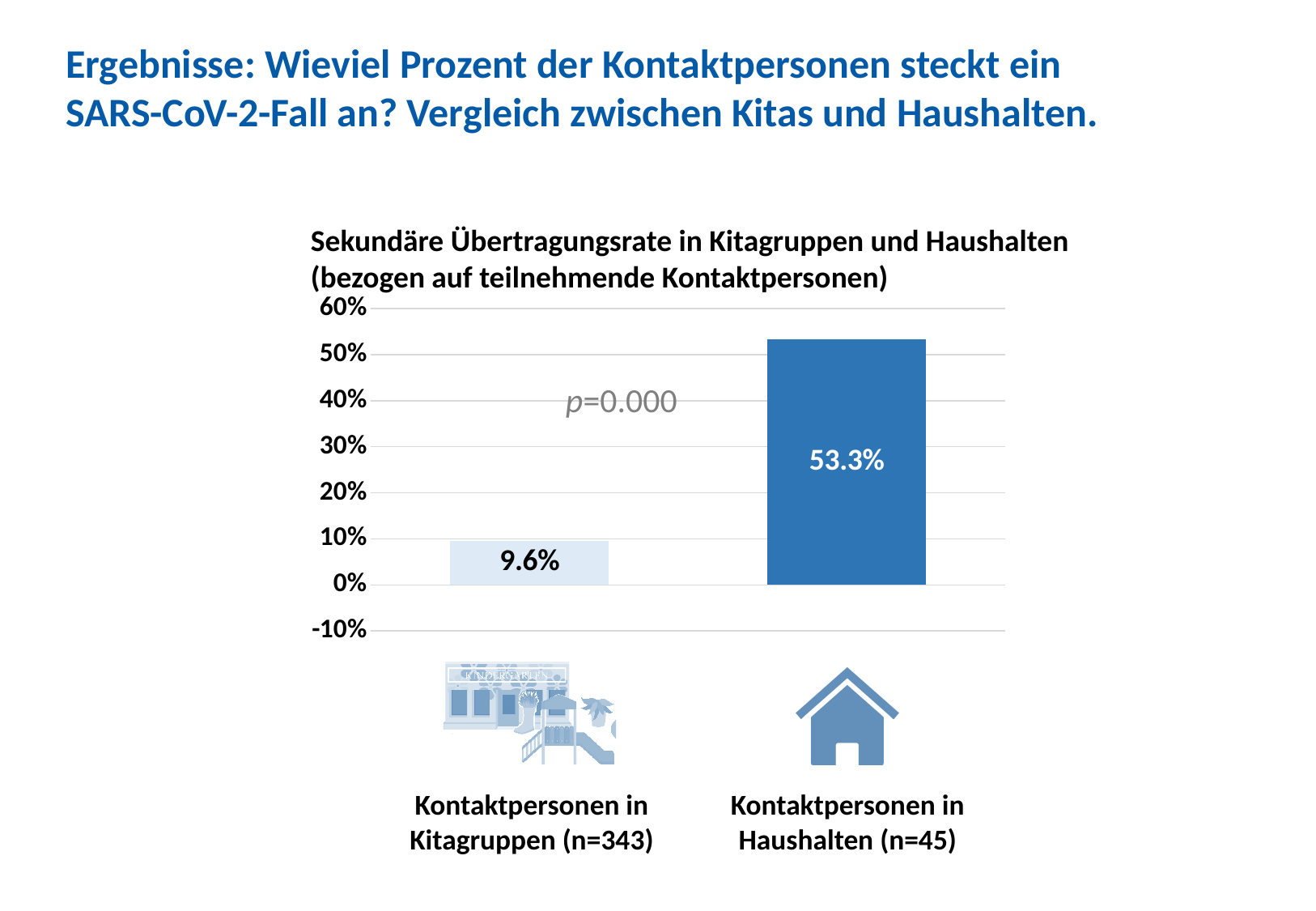
What is the secondary transmission rate for Kontaktpersonen in Kitagruppen (n=343)? 9.6% What is the title of the chart? Sekundäre Übertragungsrate in Kitagruppen und Haushalten (bezogen auf teilnehmende Kontaktpersonen) How many categories are shown in the chart? 2 Is the value for Kontaktpersonen in Haushalten greater or less than 50%? greater Is the value for Kontaktpersonen in Kitagruppen greater or less than 10%? less What is the highest value shown on the y axis? 60% What is the difference in percentage points between the Haushalten rate and the Kitagruppen rate? 43.7 percentage points Which category has the higher secondary transmission rate? Kontaktpersonen in Haushalten (n=45) What kind of chart is shown on the slide? Bar chart Which category has the lower secondary transmission rate? Kontaktpersonen in Kitagruppen (n=343) What p-value is printed on the chart? p=0.000 What is the secondary transmission rate for Kontaktpersonen in Haushalten (n=45)? 53.3%